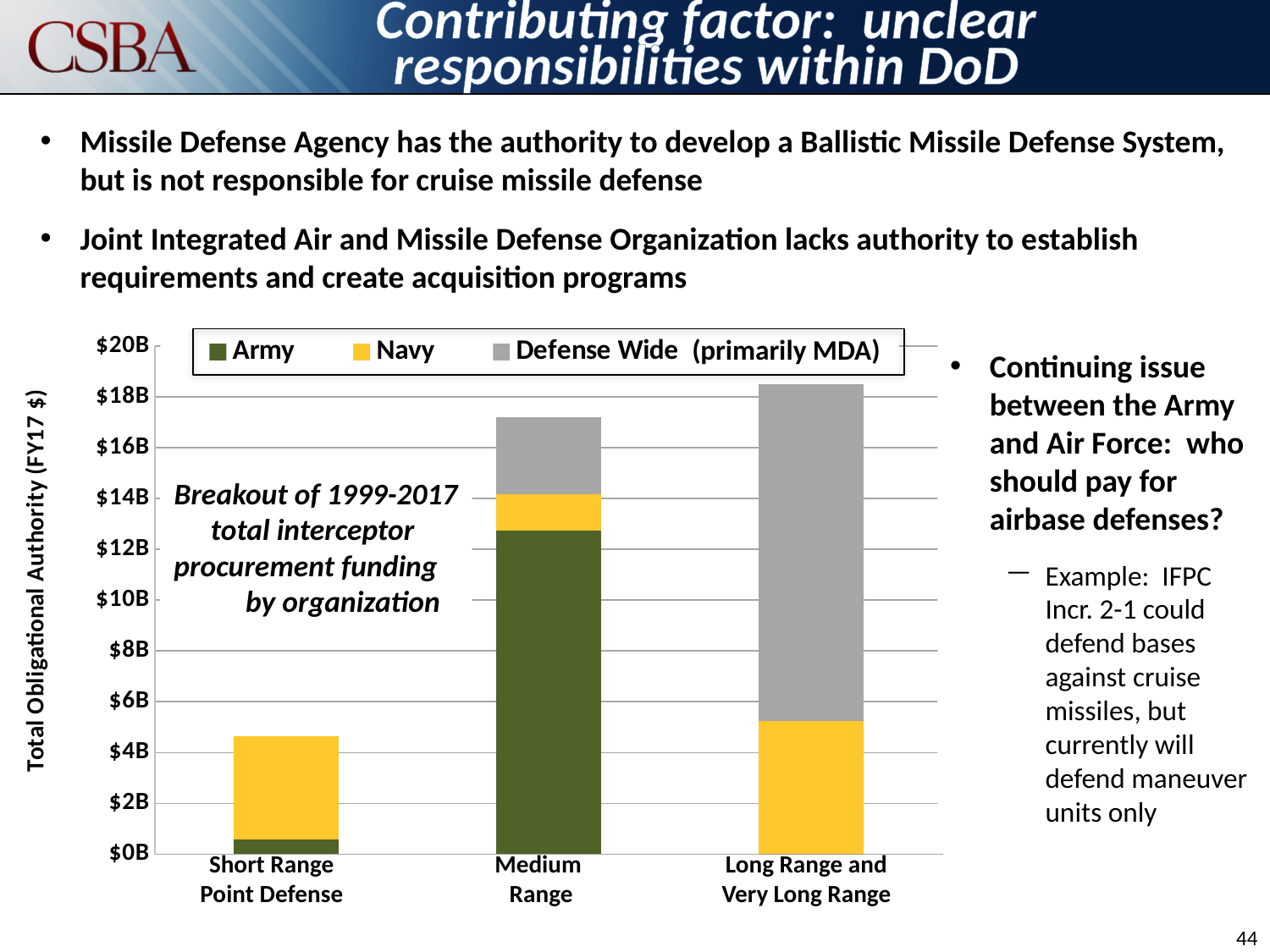
Is the total bar for Medium Range greater or less than $16B? greater Is the total bar for Short Range Point Defense greater or less than $6B? less Is the Army portion of the Medium Range bar greater or less than $12B? greater Which category has the tallest stacked bar in the chart? Long Range and Very Long Range What is the label on the chart's vertical axis? Total Obligational Authority (FY17 $) How many series does the chart's legend list? 3 Which series is shown in gray in the chart's legend? Defense Wide (primarily MDA) Which is larger: the total bar for Medium Range or the total bar for Short Range Point Defense? Medium Range Which category has the shortest stacked bar in the chart? Short Range Point Defense How many categories are shown on the x axis of the chart? 3 What kind of chart is shown on the slide? Stacked bar chart